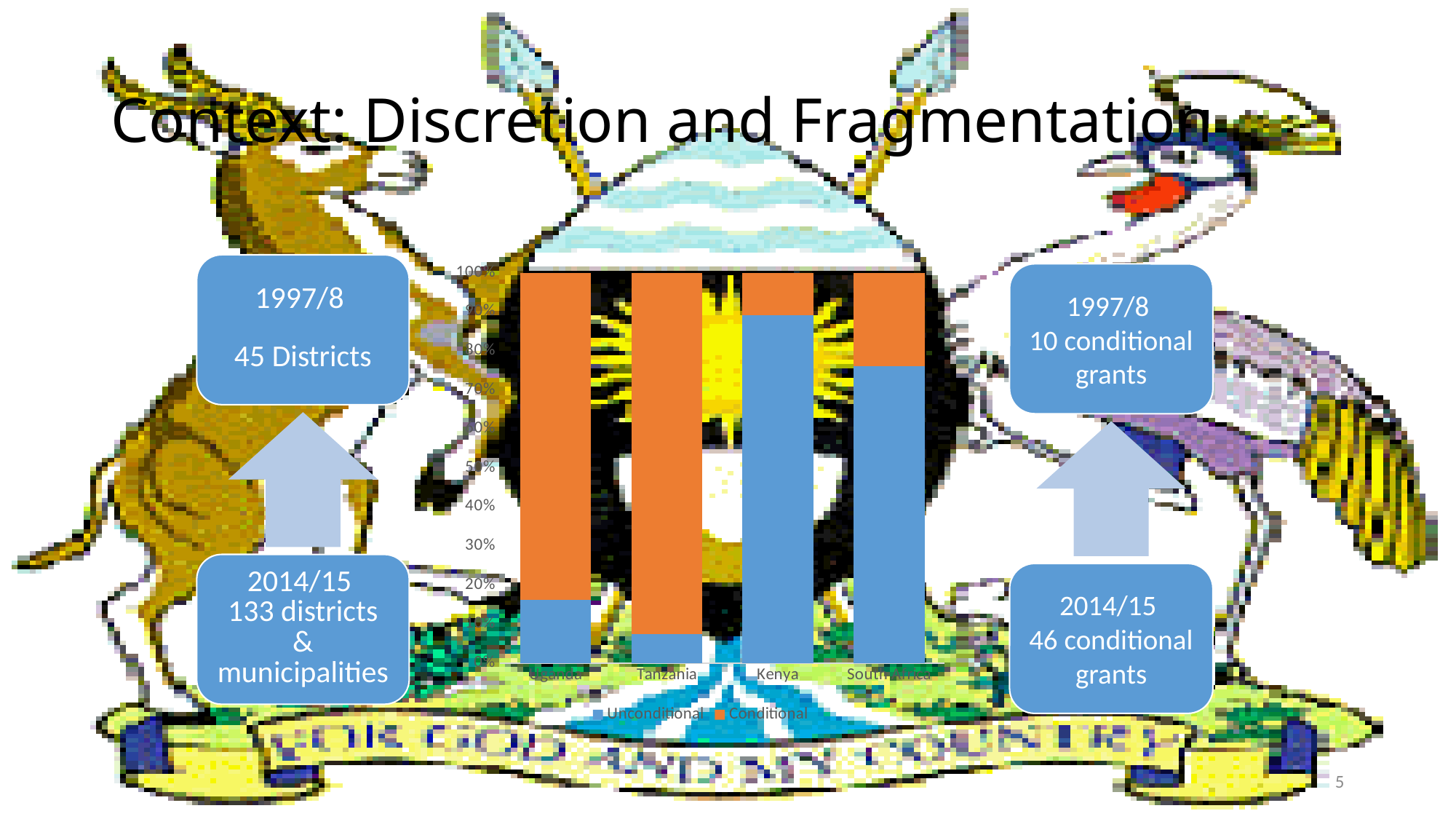
Is the Unconditional share for South Africa greater or less than 60%? greater Is the Unconditional share for Uganda greater or less than 50%? less Which country has the smallest Unconditional share in the chart? Tanzania How many series does the chart legend list? 2 Is the Unconditional share for Kenya greater or less than 80%? greater Which is larger, the Conditional share for Uganda or for Kenya? Uganda Which colour represents the Conditional series in the chart? orange What kind of chart is shown on the slide? stacked bar chart Which country has the largest Unconditional share in the chart? Kenya Which is larger, the Unconditional share for Kenya or for South Africa? Kenya Which country has the largest Conditional share in the chart? Tanzania How many countries are shown on the x axis of the chart? 4